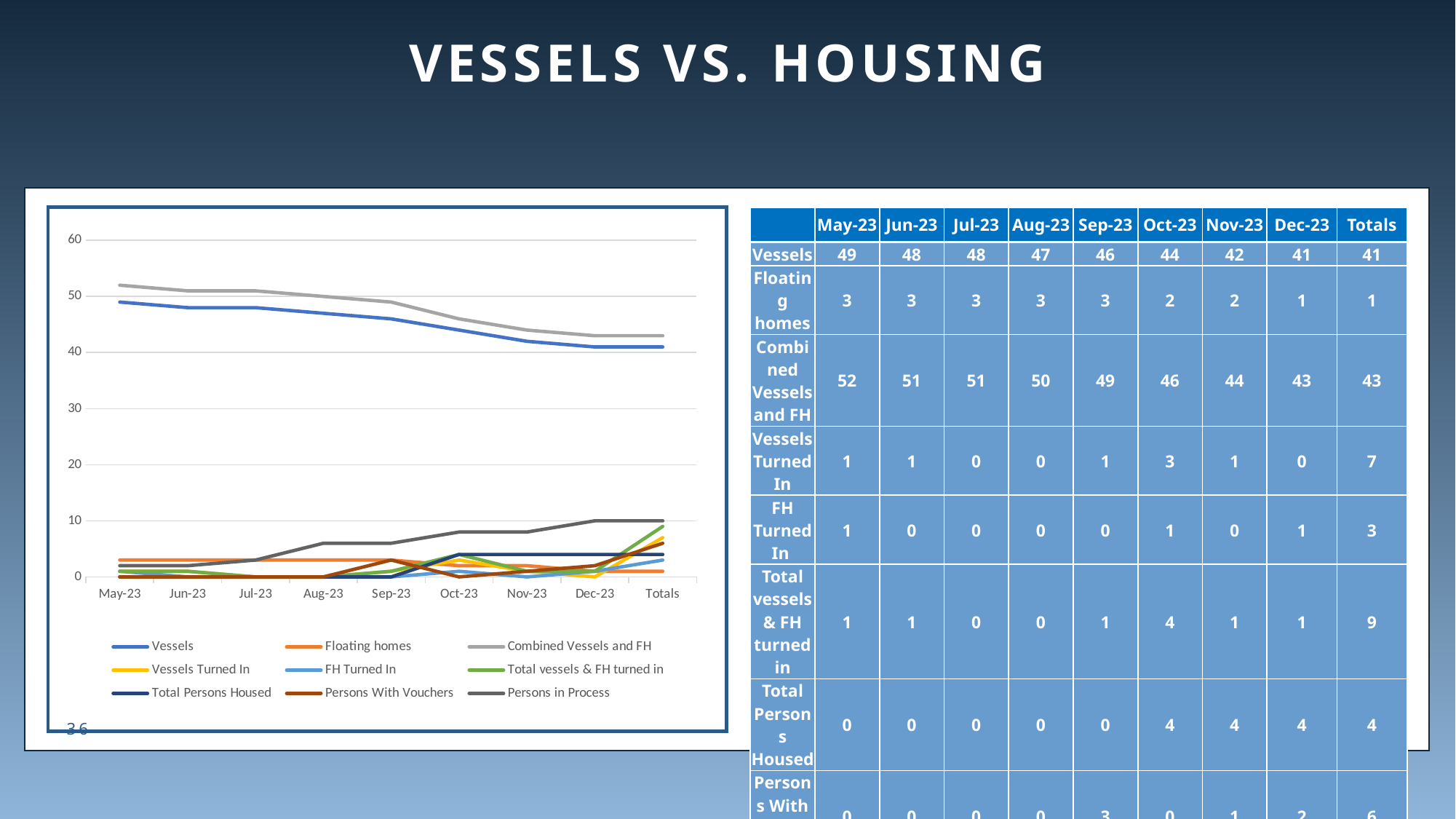
Which series has the highest value in May-23? Combined Vessels and FH What is the value for Combined Vessels and FH in Dec-23? 43 What is the difference between Combined Vessels and FH and Vessels in May-23? 3 Does the Vessels line rise or fall from May-23 to Dec-23? fall At the Totals point, which is higher: Persons in Process or Total Persons Housed? Persons in Process How many categories are shown along the x axis of the chart? 9 Is the value for Combined Vessels and FH in May-23 greater or less than 50? greater What type of chart is shown on the slide? line chart How many series does the chart legend list? 9 Is the value for Vessels in Dec-23 greater or less than 50? less What is the value for Vessels in May-23? 49 What is the Totals value for Vessels Turned In? 7